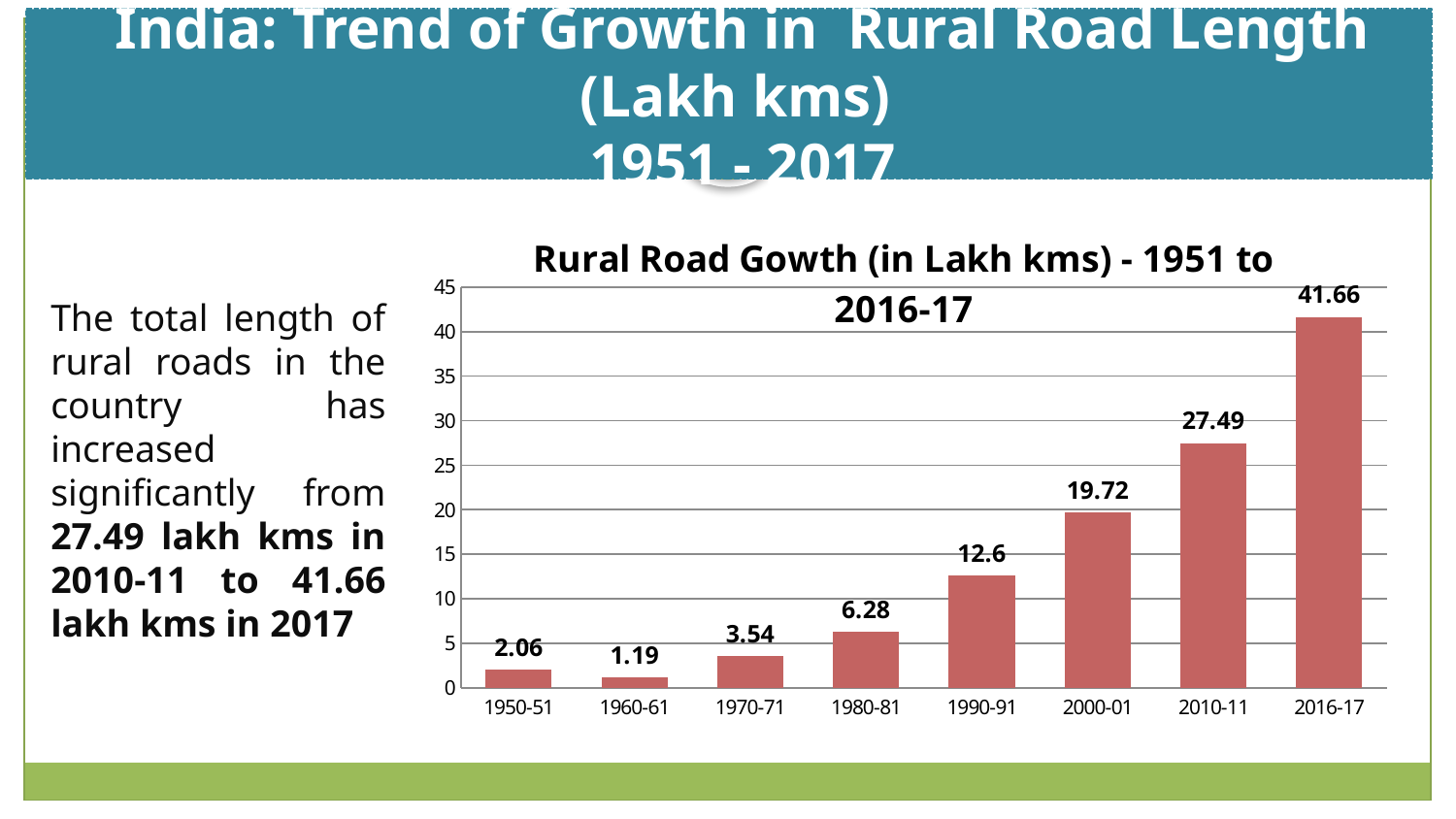
What is the value for 1990-91? 12.6 Do the values generally rise or fall from 1960-61 to 2016-17? rise Which period has the highest value? 2016-17 What is the difference between the values for 2016-17 and 2010-11? 14.17 How many periods are shown on the x axis? 8 What is the value for 1980-81? 6.28 What is the value for 2000-01? 19.72 Which is larger, the value for 1950-51 or the value for 1960-61? 1950-51 What kind of chart is this? bar chart Which period has the lowest value? 1960-61 Is the value for 2010-11 greater or less than 25? greater What is the difference between the values for 1970-71 and 1960-61? 2.35